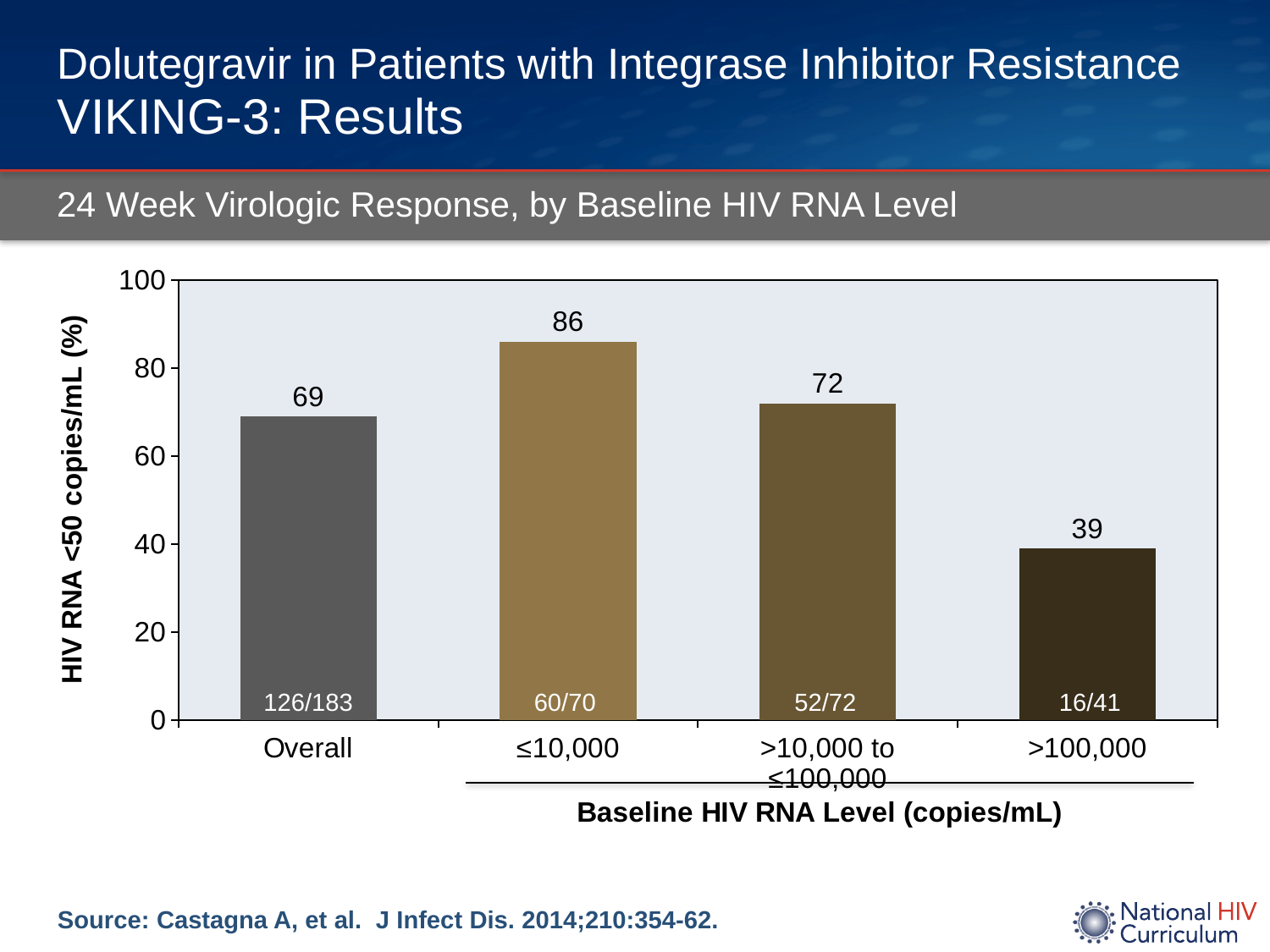
What type of chart is shown on the slide? Bar chart Which has a higher virologic response percentage, the Overall group or the >10,000 to ≤100,000 group? >10,000 to ≤100,000 What is the difference in percentage between the ≤10,000 group and the >100,000 group? 47 Which category has the lowest virologic response percentage? >100,000 What fraction is shown inside the Overall bar? 126/183 Which baseline HIV RNA category has the highest virologic response percentage? ≤10,000 What is the label of the y-axis? HIV RNA <50 copies/mL (%) What is the percentage of patients with HIV RNA <50 copies/mL for the ≤10,000 baseline HIV RNA group? 86 How many bars are shown in the chart? 4 What fraction is shown inside the bar for the >10,000 to ≤100,000 group? 52/72 What is the percentage of patients with HIV RNA <50 copies/mL in the Overall group? 69 What is the percentage of patients with HIV RNA <50 copies/mL for the >100,000 baseline HIV RNA group? 39